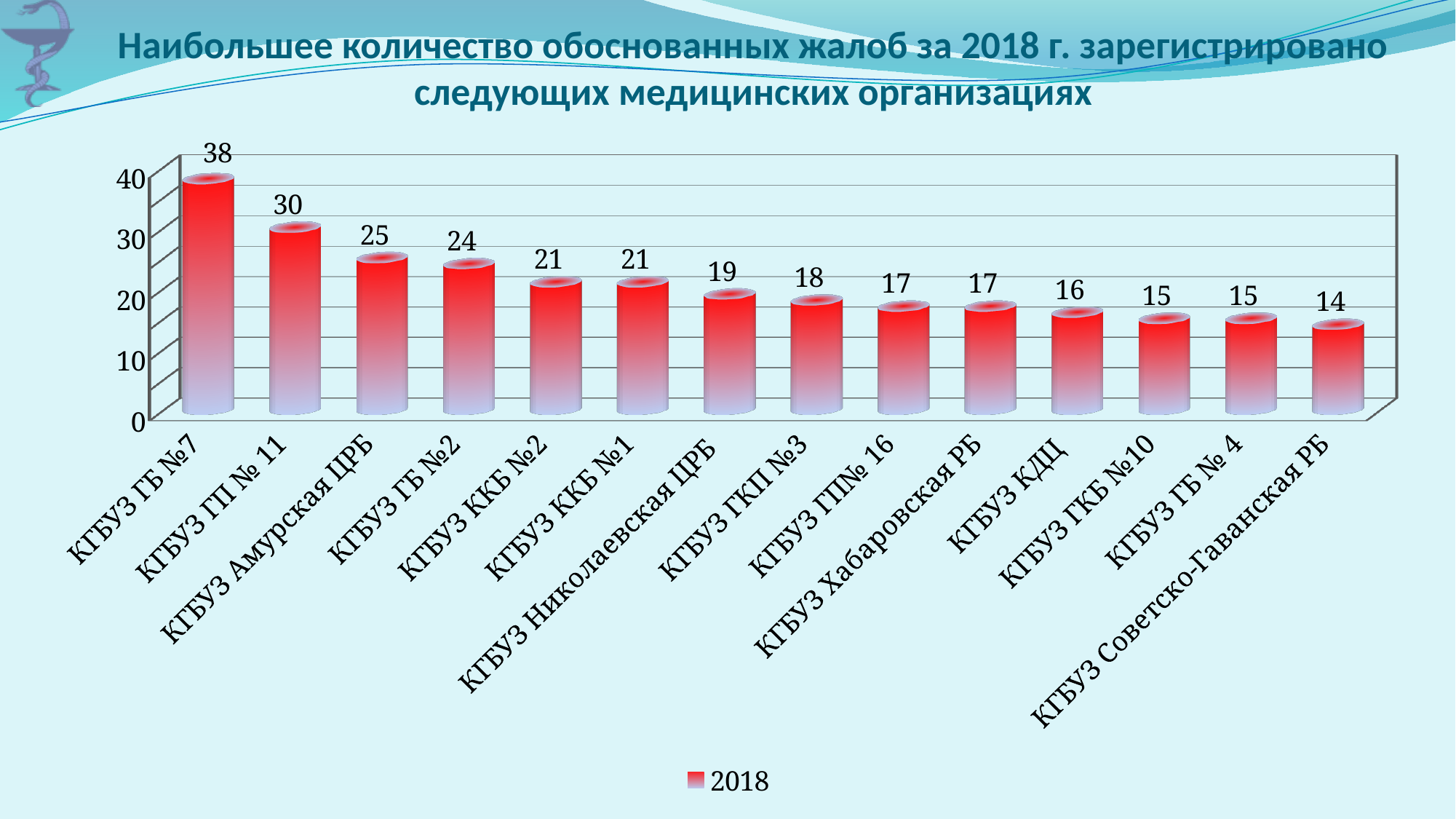
What is the difference between the values for КГБУЗ ГБ №7 and КГБУЗ ГП № 11? 8 Which category has the lowest value? КГБУЗ Советско-Гаванская РБ How many series does the legend list? 1 What kind of chart is shown on the slide? bar chart What is the value for КГБУЗ Николаевская ЦРБ? 19 How many categories are shown on the chart? 14 Is the value for КГБУЗ ГКП №3 greater or less than 20? less What is the value for КГБУЗ КДЦ? 16 Which is larger, the value for КГБУЗ Амурская ЦРБ or the value for КГБУЗ ГБ №2? КГБУЗ Амурская ЦРБ What is the legend entry shown below the chart? 2018 What is the value for КГБУЗ ГБ №7? 38 Which category has the highest value? КГБУЗ ГБ №7